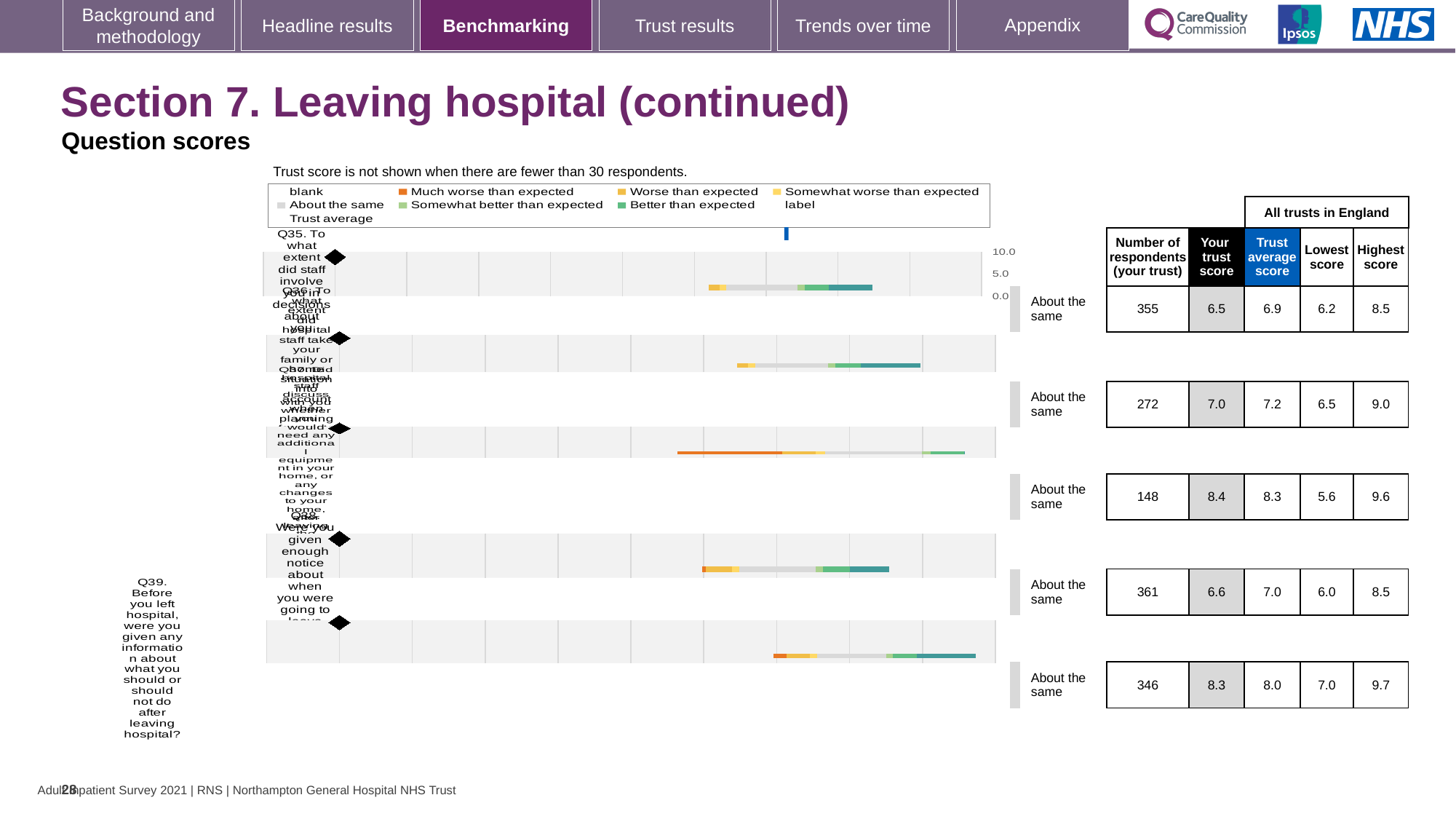
What is the lowest number of respondents shown in the table? 148 For the first question row (Q35), is 'Your trust score' (6.5) higher or lower than the trust average score (6.9)? lower What kind of chart is used to show the question scores on this slide? bar chart For Q39, is 'Your trust score' higher or lower than the trust average score? higher What is the highest score among all trusts in England for Q39? 9.7 How many questions (rows) are shown in the benchmarking chart and table? 5 What is 'Your trust score' for Q39? 8.3 What is the number of respondents for the first question row (Q35) in the table? 355 What is the number of respondents for Q39 (information about what you should or should not do after leaving hospital)? 346 According to the note above the chart, below how many respondents is the trust score not shown? 30 For Q39, what is the difference between the highest score (9.7) and the lowest score (7.0)? 2.7 What is the trust average score for Q39? 8.0